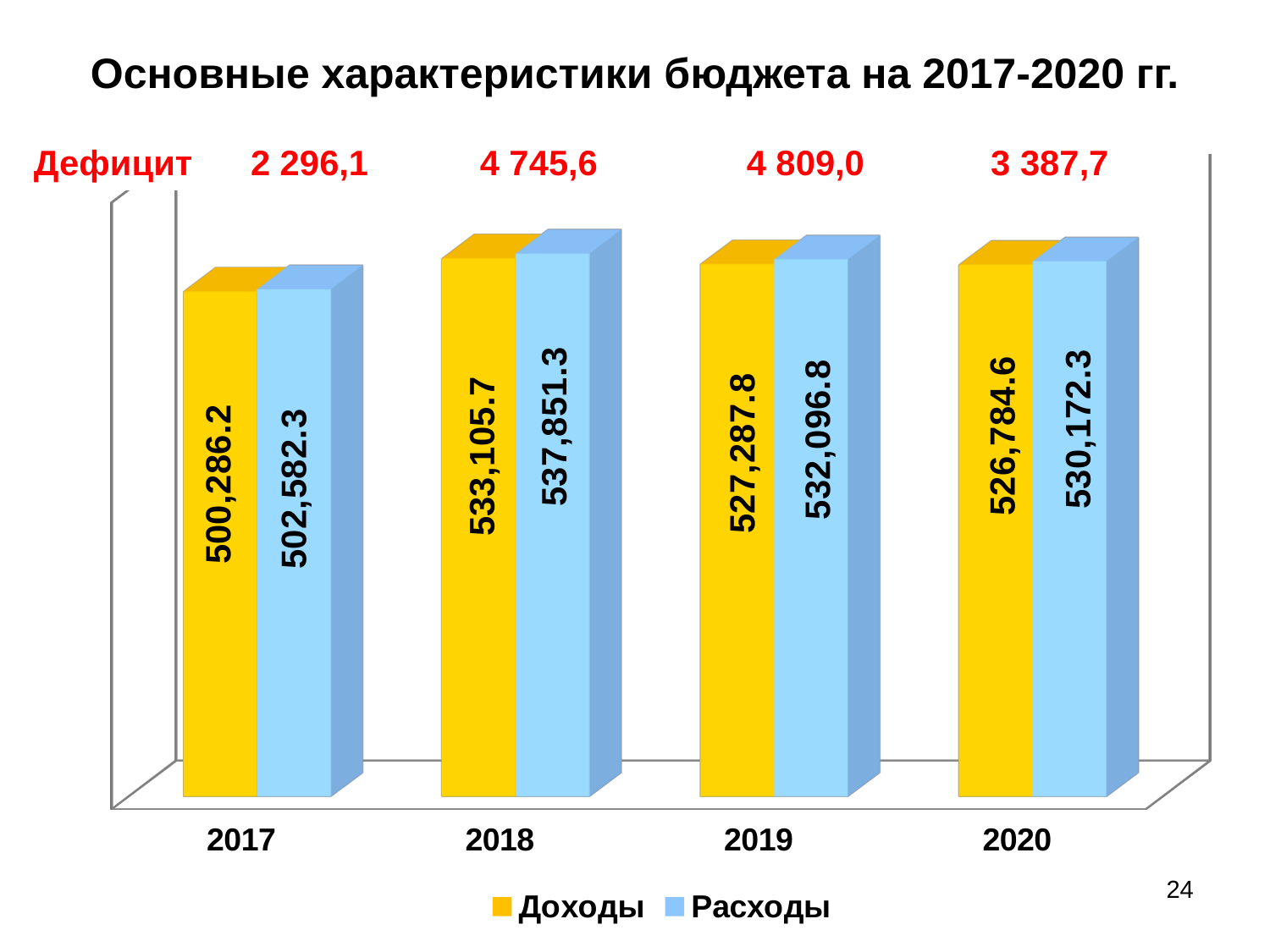
How many series does the legend list? 2 In which year is Доходы the highest? 2018 What is the value of Доходы for 2017? 500,286.2 How many years are shown on the x axis? 4 What kind of chart is shown on the slide? Bar chart What is the difference between Доходы in 2018 and Доходы in 2019? 5,817.9 What is the value of Расходы for 2020? 530,172.3 What is the value of Расходы for 2018? 537,851.3 Which is larger in 2020, Доходы or Расходы? Расходы In which year is Расходы the lowest? 2017 What is the difference between Расходы and Доходы in 2018? 4,745.6 What is the value of Доходы for 2019? 527,287.8